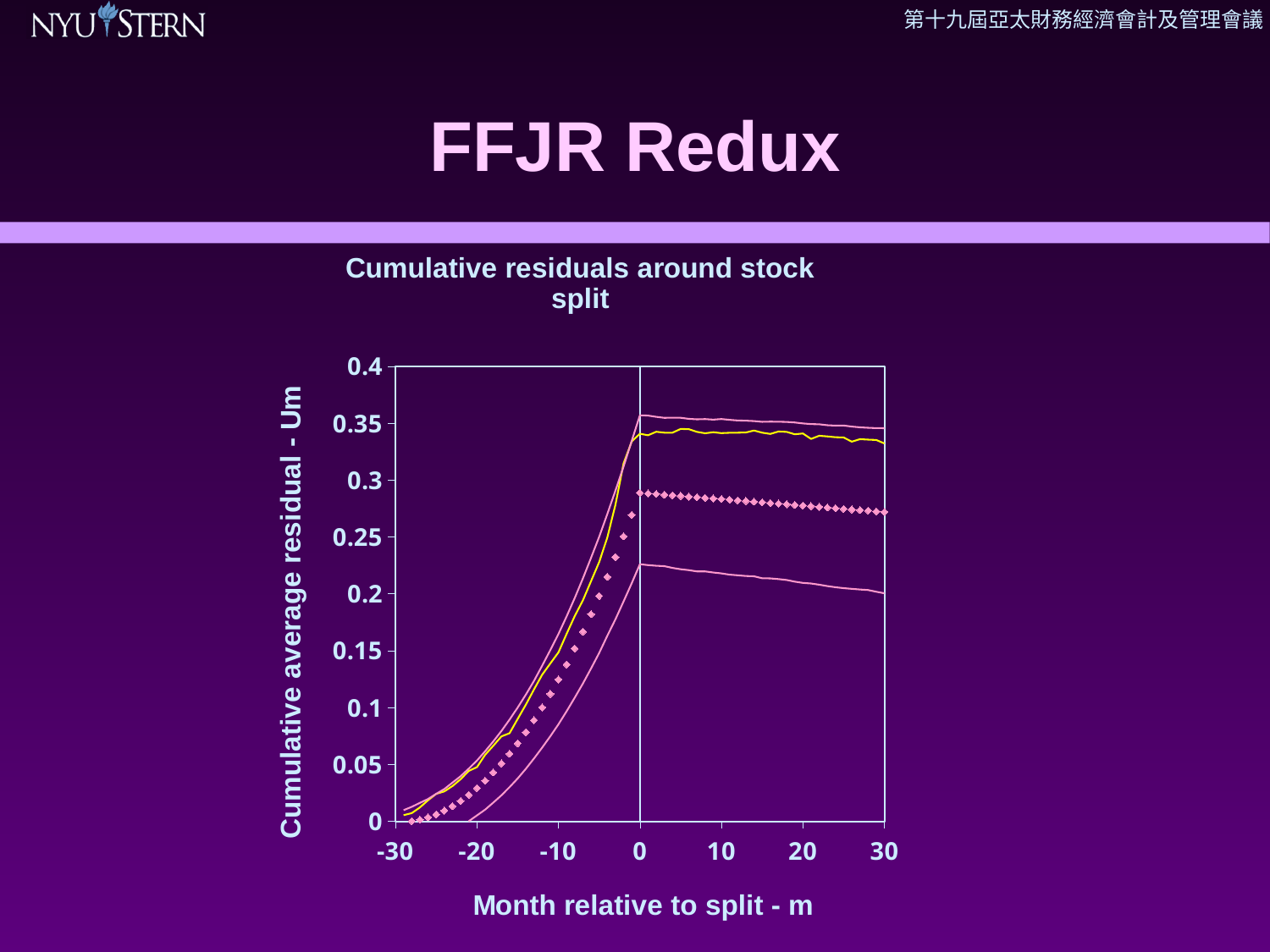
Is the value of the yellow line at month -10 greater or less than 0.1? greater What is the title of the chart? Cumulative residuals around stock split What is the label of the horizontal axis? Month relative to split - m How many tick labels are shown on the horizontal axis? 7 Is the value of the yellow line at month 0 greater or less than 0.3? greater Is the value of the upper pink line at month 30 greater or less than 0.3? greater Do the plotted values rise or fall as the month goes from -30 to 0? rise What kind of chart is shown on the slide? line chart Does the diamond-marker series rise or fall between month 0 and month 30? fall